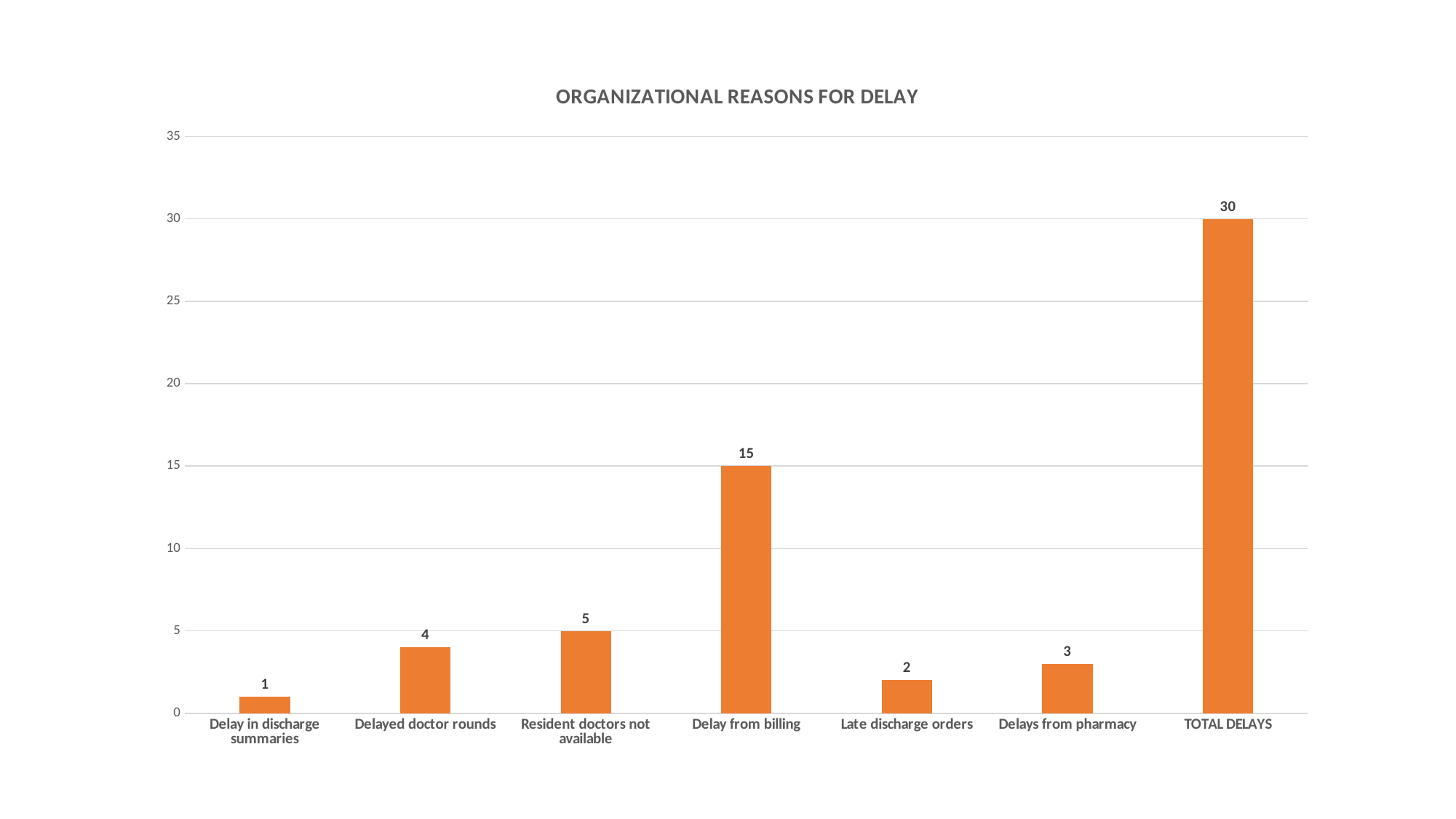
What is the value for Delay from billing? 15 Which category has the highest value? TOTAL DELAYS Which is larger, Delays from pharmacy or Delayed doctor rounds? Delayed doctor rounds What is the value for TOTAL DELAYS? 30 Is the value for Delay from billing greater or less than 10? greater What kind of chart is this? Bar chart What is the value for Late discharge orders? 2 What is the value for Delayed doctor rounds? 4 How many categories are shown on the x axis? 7 What is the difference between Delay from billing and Resident doctors not available? 10 What is the title of the chart? ORGANIZATIONAL REASONS FOR DELAY Which category has the lowest value? Delay in discharge summaries